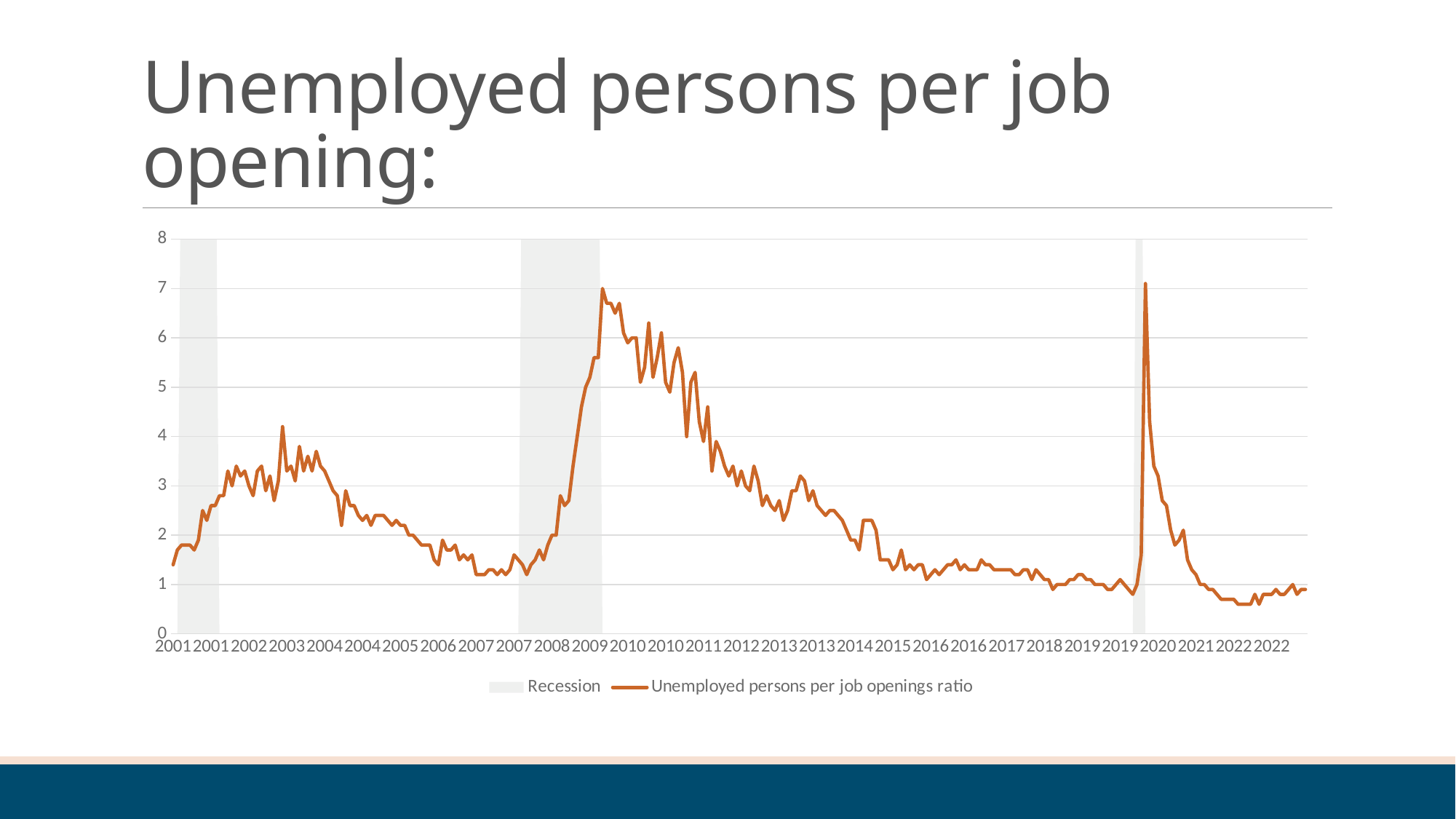
Is the value of the ratio at the end of 2022 greater or less than 2? less Is the highest value of the ratio in 2003 greater or less than 5? less Which is higher: the peak of the ratio around 2009 or the peak around 2003? the peak around 2009 What is the name of the orange line series in the legend? Unemployed persons per job openings ratio Between 2010 and 2019, does the ratio generally rise or fall? fall Is the value of the ratio at the start of 2001 greater or less than 2? less What kind of chart is shown on the slide? line chart Between 2007 and 2009, does the ratio rise or fall? rise How many entries does the chart's legend list? 2 What does the grey shading in the chart represent, according to the legend? Recession